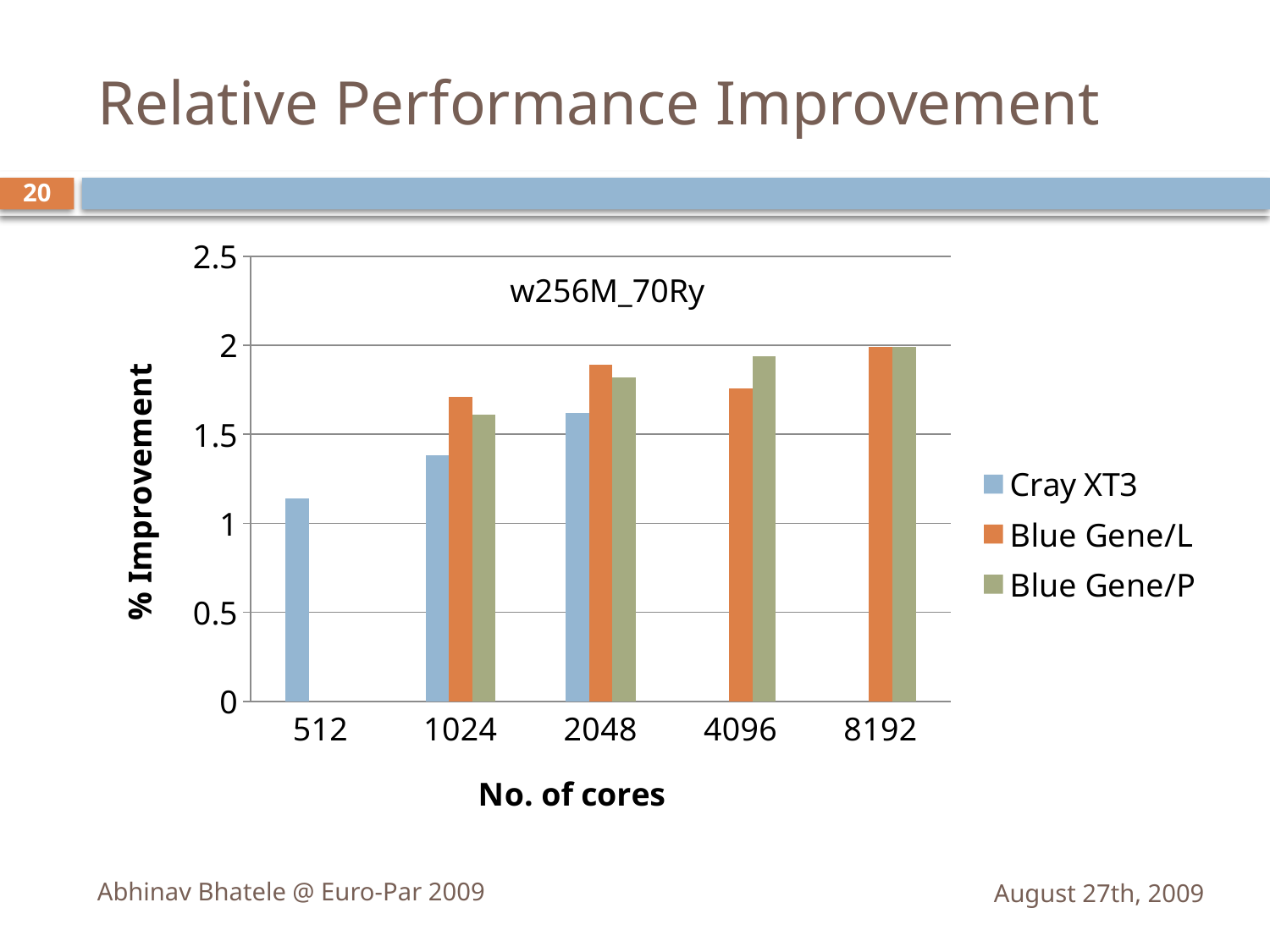
At 4096 cores, which is larger: Blue Gene/L or Blue Gene/P? Blue Gene/P Is the Cray XT3 value at 1024 cores greater or less than 1.5? less What kind of chart is shown on the slide? bar chart Is the Cray XT3 value at 512 cores greater or less than 1? greater Is the Blue Gene/L value at 1024 cores greater or less than 1.5? greater How many core-count categories are shown on the x axis? 5 At 1024 cores, which is larger: Blue Gene/L or Blue Gene/P? Blue Gene/L What is the title shown inside the chart area? w256M_70Ry Do the Cray XT3 values rise or fall as the number of cores increases from 512 to 2048? rise At 2048 cores, which is larger: Cray XT3 or Blue Gene/L? Blue Gene/L How many series does the legend list? 3